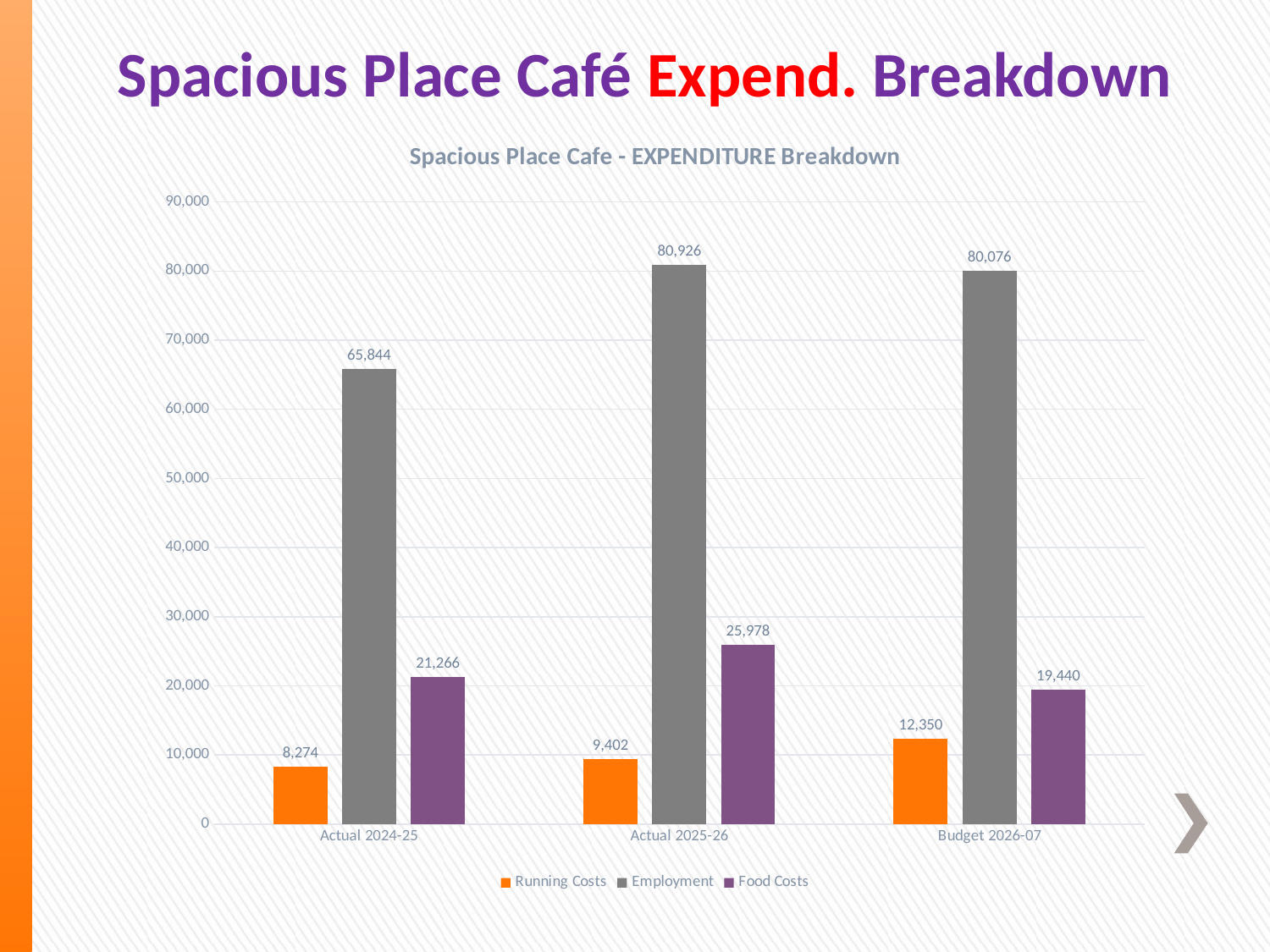
What kind of chart is shown on the slide? bar chart How many series does the legend list? 3 How many categories are shown on the x axis? 3 Do the Running Costs values rise or fall from Actual 2024-25 to Budget 2026-07? rise What is the Running Costs value for Budget 2026-07? 12,350 Which category has the lowest Running Costs value? Actual 2024-25 What is the Food Costs value for Actual 2024-25? 21,266 What is the difference between the Employment values for Actual 2025-26 and Actual 2024-25? 15,082 Is the Employment value for Actual 2024-25 greater or less than 70,000? less What is the Employment value for Actual 2025-26? 80,926 Which is larger: Food Costs for Budget 2026-07 or Food Costs for Actual 2024-25? Food Costs for Actual 2024-25 Which category has the highest Food Costs value? Actual 2025-26